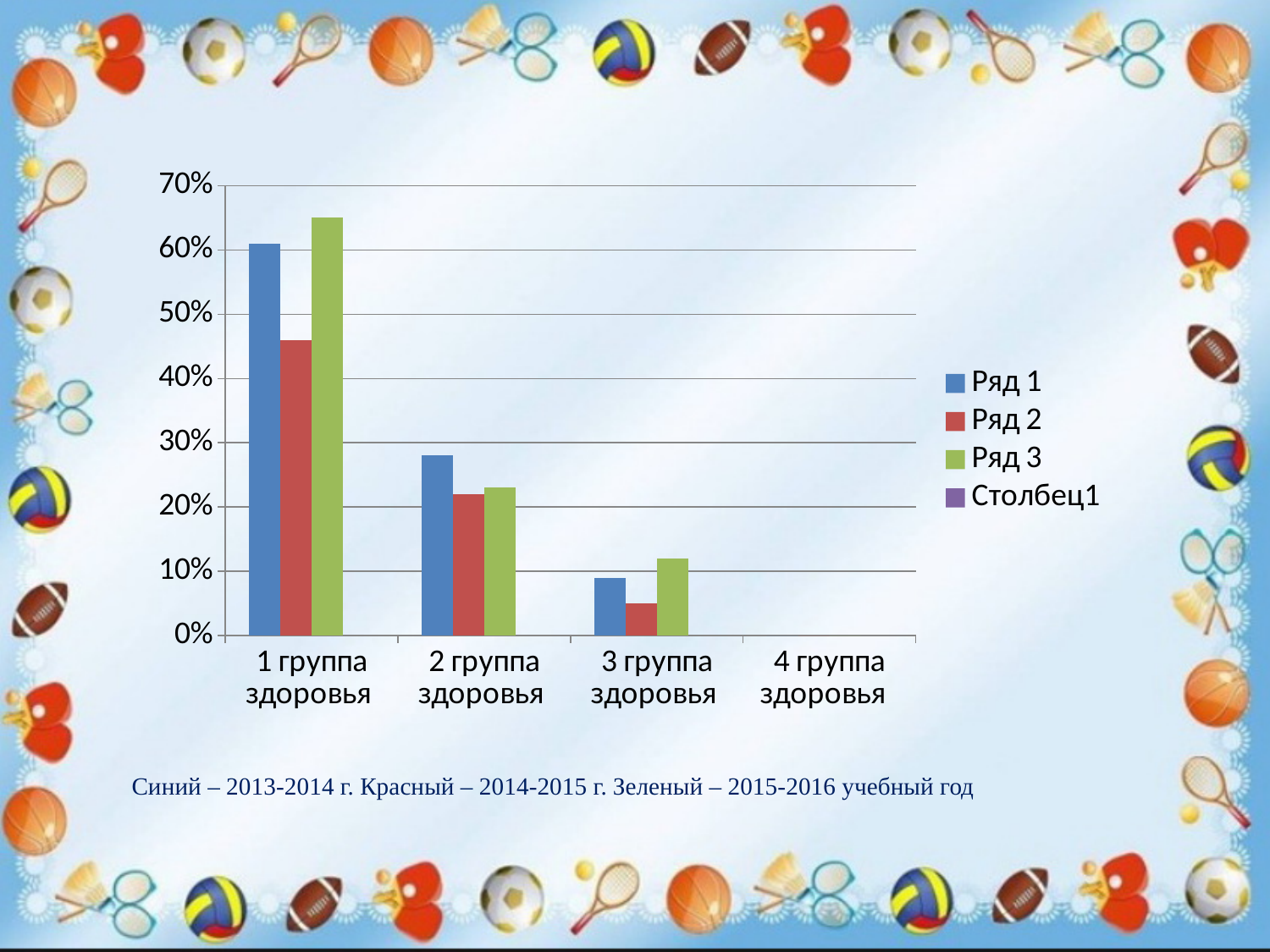
Is the value for Ряд 2 in 3 группа здоровья greater or less than 10%? less Is the value for Ряд 2 in 1 группа здоровья greater or less than 50%? less Which is larger in 1 группа здоровья, the value for Ряд 1 or the value for Ряд 2? Ряд 1 Which category has the highest value for Ряд 1? 1 группа здоровья Is the value for Ряд 1 in 1 группа здоровья greater or less than 50%? greater What kind of chart is shown on the slide? bar chart Which series has the lowest value in the 3 группа здоровья category? Ряд 2 Which series has the highest value in the 1 группа здоровья category? Ряд 3 How many categories are shown on the x axis? 4 According to the caption below the chart, which school year does the green colour represent? 2015-2016 учебный год Do the values for Ряд 1 rise or fall from 1 группа здоровья to 3 группа здоровья? fall How many series does the legend list? 4